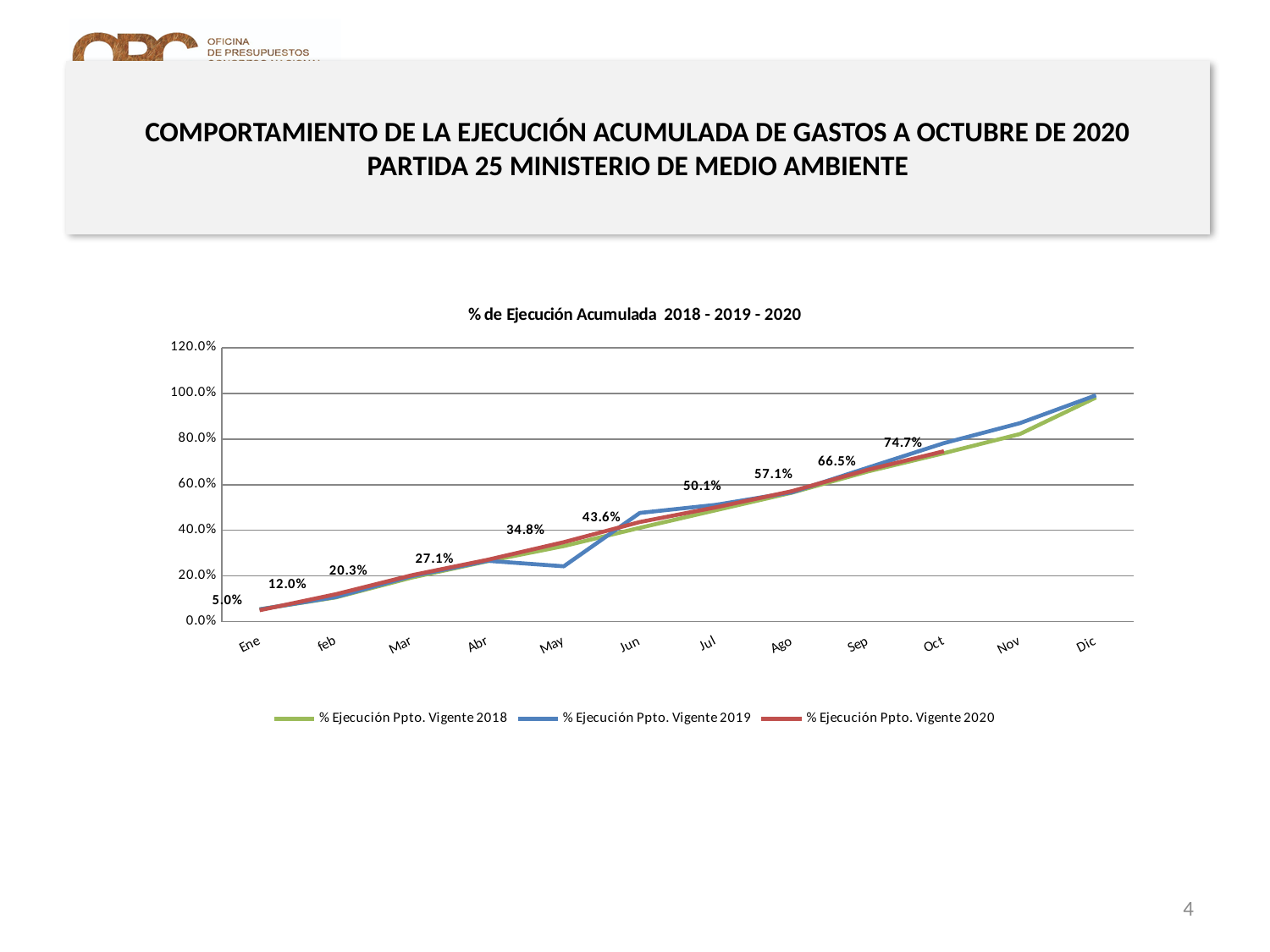
What is the value labelled for % Ejecución Ppto. Vigente 2020 in Oct? 74.7% What kind of chart is shown on the slide? line chart How many months are shown on the x axis? 12 What is the value labelled for % Ejecución Ppto. Vigente 2020 in Jun? 43.6% Is the value for % Ejecución Ppto. Vigente 2019 in Dic greater or less than 80.0%? greater What is the value labelled for % Ejecución Ppto. Vigente 2020 in Mar? 20.3% Do the values of the % Ejecución Ppto. Vigente 2020 series rise or fall from Ene to Oct? rise What is the difference between the labelled 2020 values for Oct and Ene? 69.7% How many series does the legend list? 3 What is the difference between the labelled 2020 values for Sep and Ago? 9.4% Which is larger for the 2020 series: the labelled value for Jul or for May? Jul What is the chart's title? % de Ejecución Acumulada 2018 - 2019 - 2020